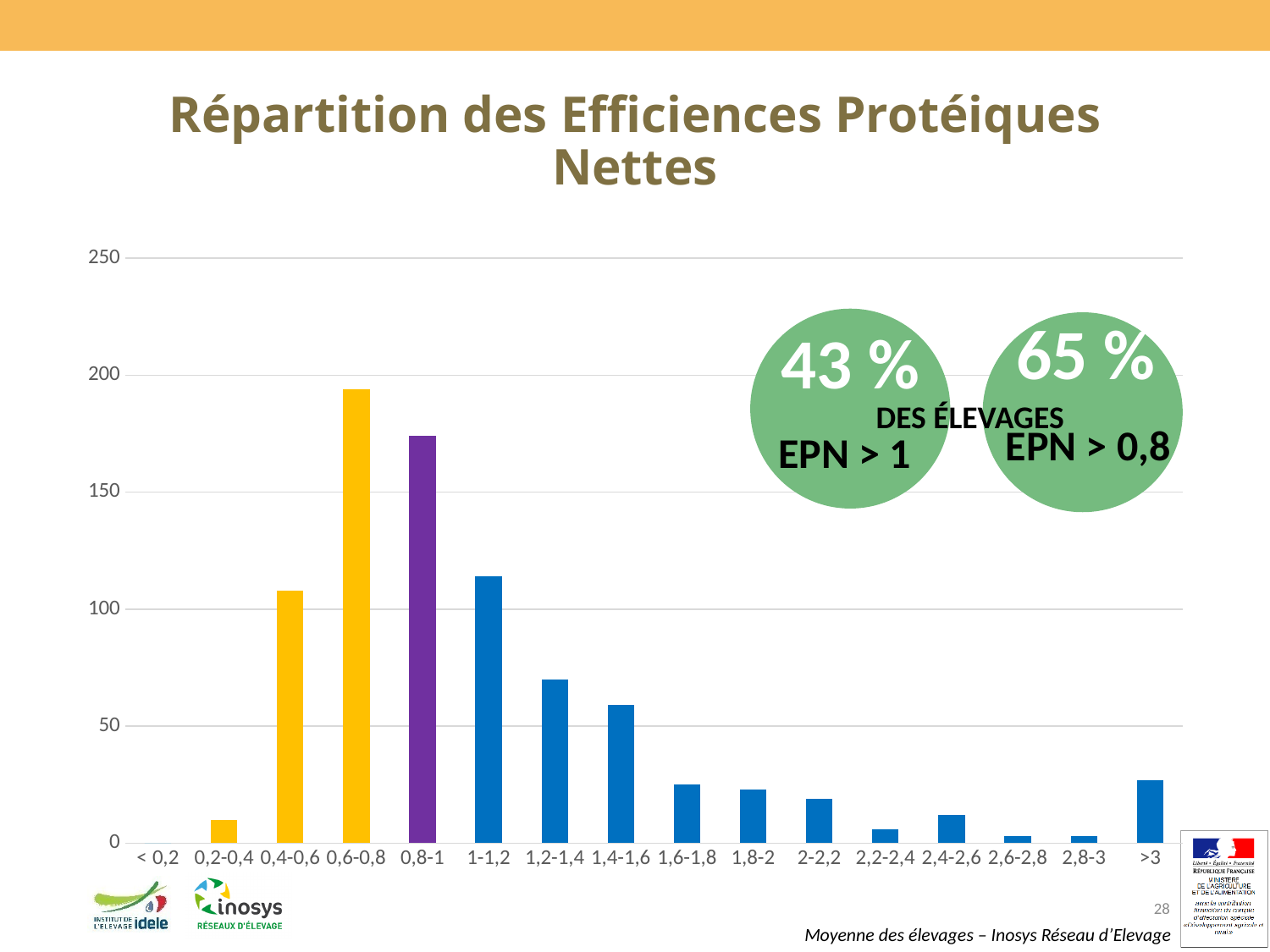
Is the value for 0,6-0,8 greater or less than 150? greater How many categories are shown on the x axis of the chart? 16 Which category has the lowest value (no visible bar)? < 0,2 Which is larger, the value for 0,6-0,8 or the value for 0,8-1? 0,6-0,8 Is the value for 0,4-0,6 greater or less than 100? greater Which is larger, the value for 1,2-1,4 or the value for 1,4-1,6? 1,2-1,4 What is the title of the chart? Répartition des Efficiences Protéiques Nettes Do the values rise or fall along the x axis from 0,6-0,8 to 1,6-1,8? fall Is the value for >3 greater or less than 50? less Which category has the highest bar? 0,6-0,8 What kind of chart is shown on the slide? bar chart